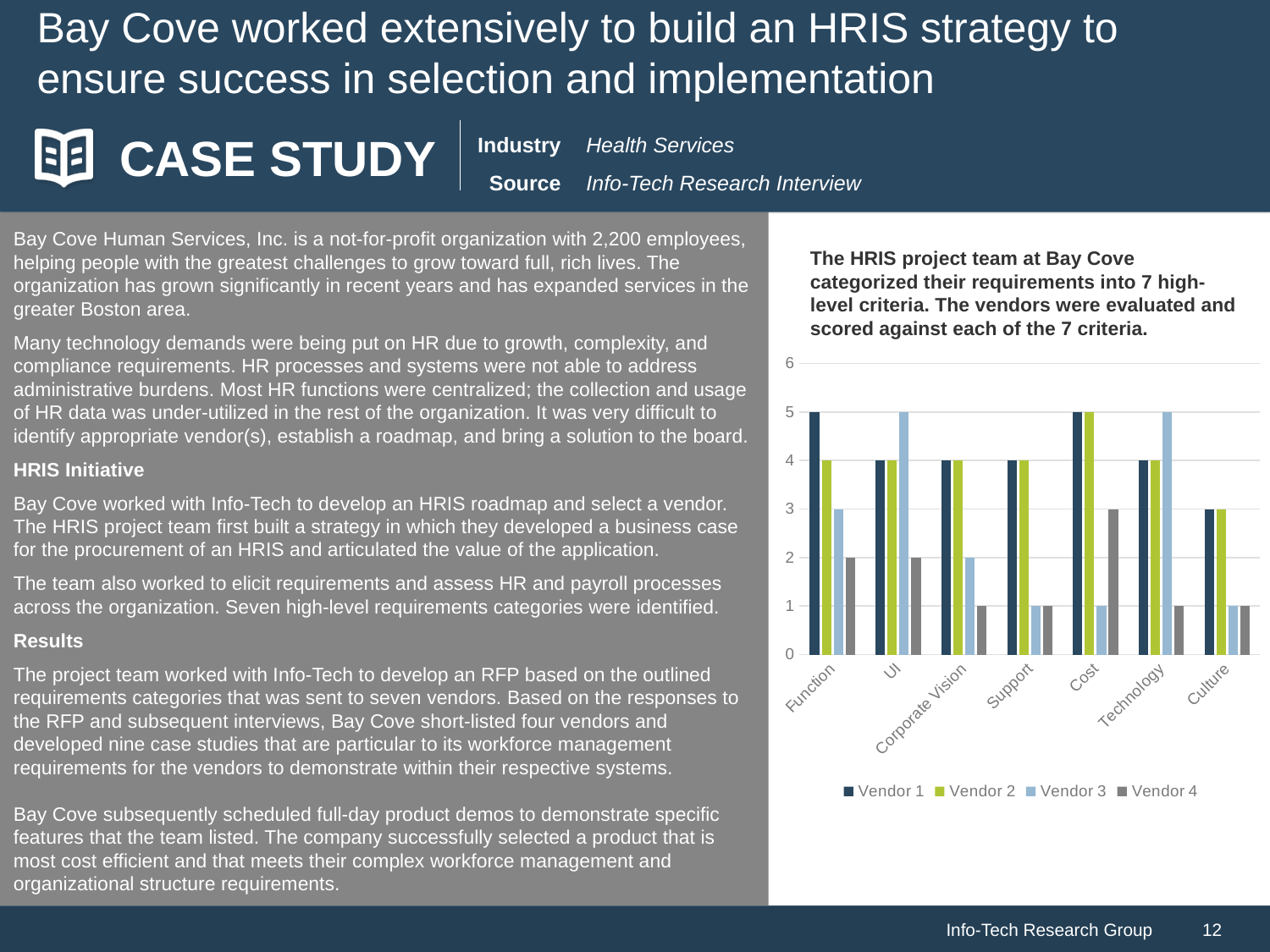
Which vendor is represented by the green bars in the chart? Vendor 2 What kind of chart is shown on the slide? Bar chart What score does Vendor 3 receive for UI? 5 What score does Vendor 3 receive for Support? 1 What is the difference between Vendor 1's and Vendor 4's scores for Function? 3 How many criteria categories are shown on the x axis of the chart? 7 How many vendors does the chart legend list? 4 What score does Vendor 1 receive for Function? 5 Which vendor has the highest score for Technology? Vendor 3 What score does Vendor 4 receive for Cost? 3 Which vendor has the lowest score for Function? Vendor 4 Which is larger: Vendor 3's score for Cost or Vendor 4's score for Cost? Vendor 4's score for Cost